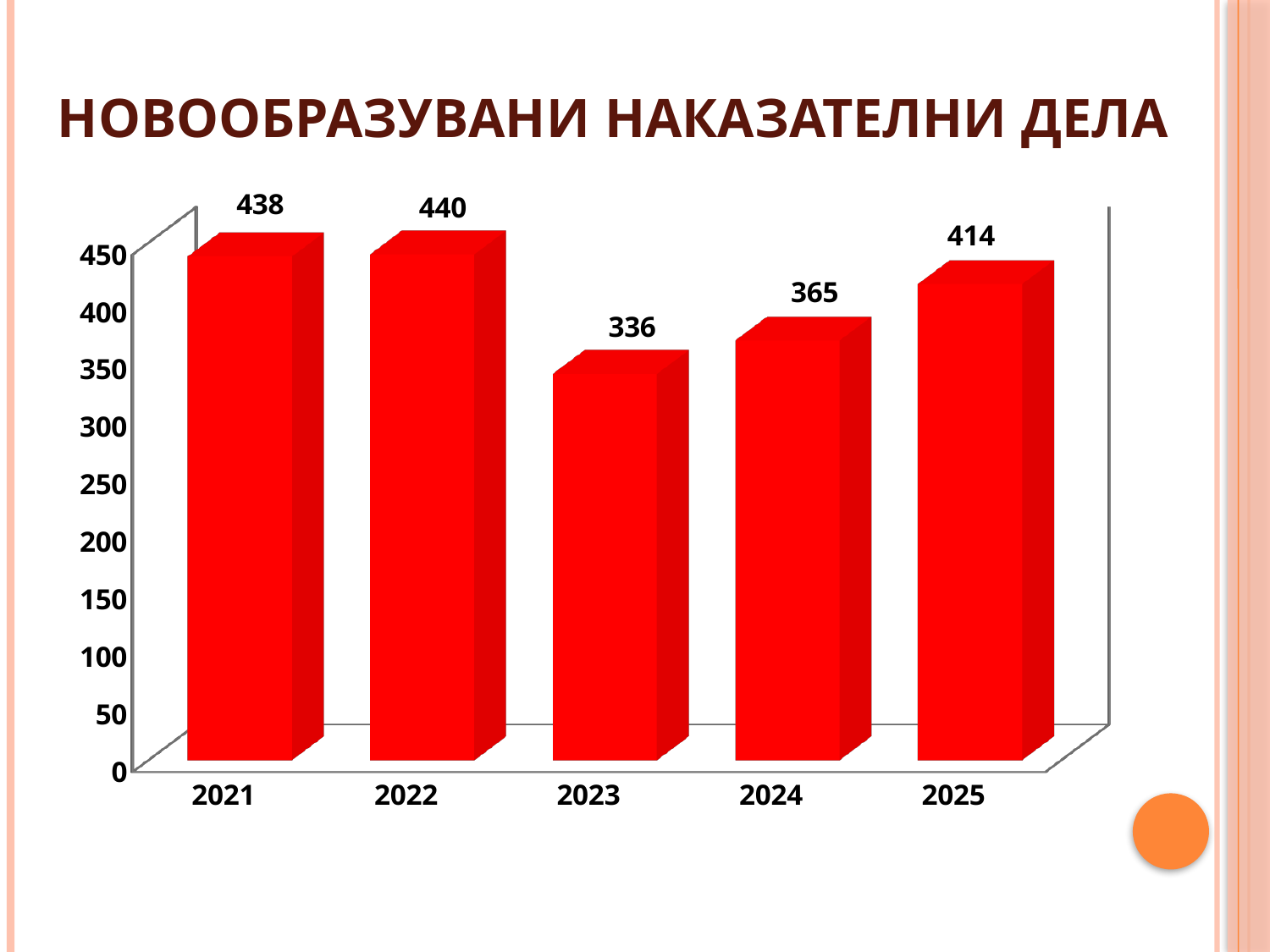
Which is larger, the value for 2024 or the value for 2025? 2025 What is the value for 2021? 438 What kind of chart is shown on the slide? bar chart How many years are shown on the x axis? 5 Is the value for 2024 greater or less than 400? less What is the value for 2023? 336 What is the value for 2025? 414 What is the difference between the values for 2025 and 2024? 49 Which year has the lowest value? 2023 Which year has the highest value? 2022 What is the difference between the values for 2022 and 2023? 104 What is the title of the chart? НОВООБРАЗУВАНИ НАКАЗАТЕЛНИ ДЕЛА